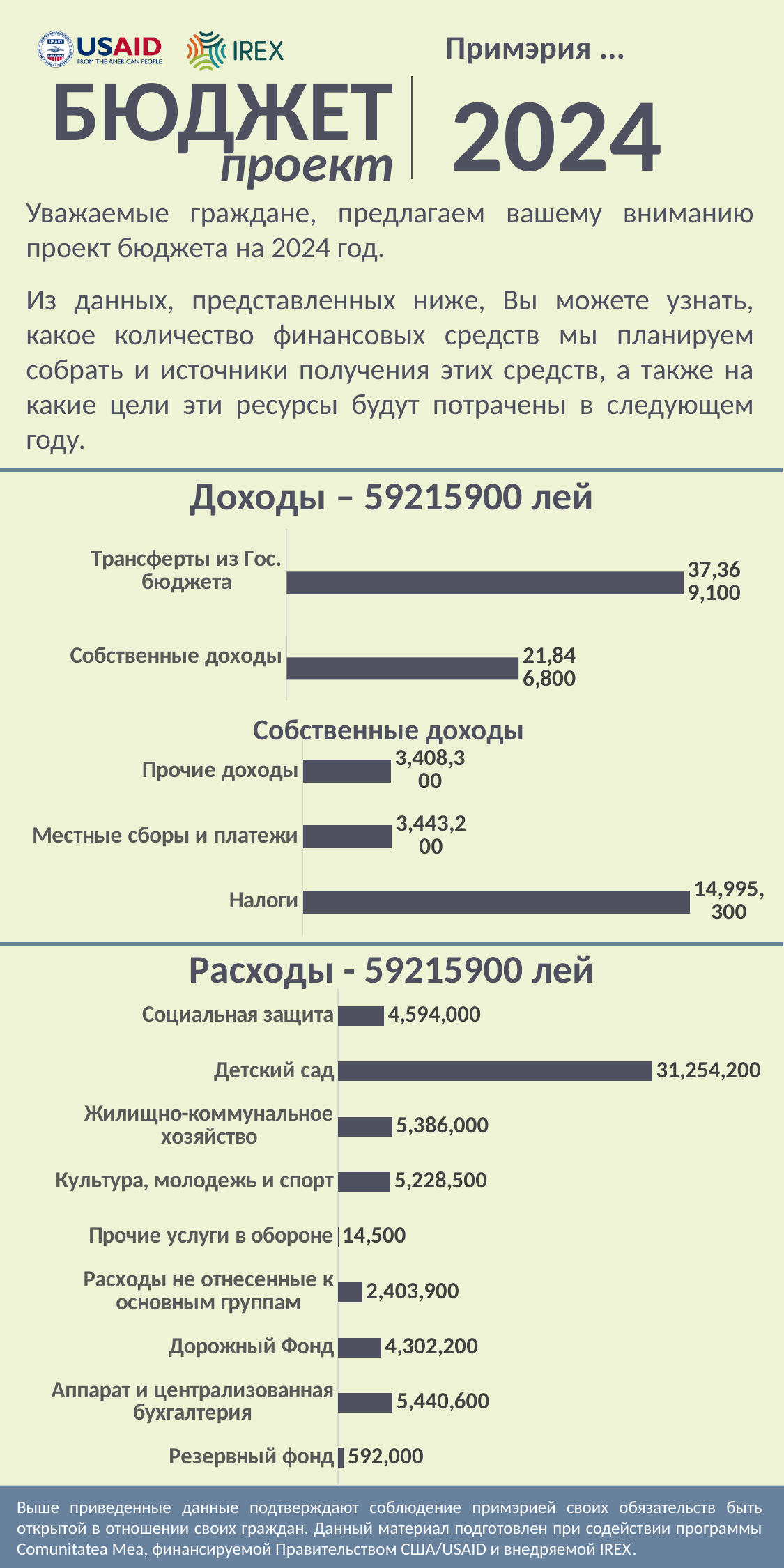
In the 'Собственные доходы' chart, what is the value for Налоги? 14,995,300 In the 'Собственные доходы' chart, how many categories are shown? 3 In the 'Собственные доходы' chart, what is the value for Местные сборы и платежи? 3,443,200 In the 'Расходы - 59215900 лей' chart, which category has the lowest value? Прочие услуги в обороне In the 'Расходы - 59215900 лей' chart, what is the value for Дорожный Фонд? 4,302,200 In the 'Расходы - 59215900 лей' chart, how many categories are shown? 9 In the 'Доходы – 59215900 лей' chart, what is the value for Трансферты из Гос. бюджета? 37,369,100 In the 'Доходы – 59215900 лей' chart, which category is larger: Трансферты из Гос. бюджета or Собственные доходы? Трансферты из Гос. бюджета What type of chart is the 'Расходы - 59215900 лей' chart? Bar chart In the 'Доходы – 59215900 лей' chart, what is the value for Собственные доходы? 21,846,800 In the 'Расходы - 59215900 лей' chart, which category has the highest value? Детский сад In the 'Собственные доходы' chart, what is the difference between Местные сборы и платежи and Прочие доходы? 34,900